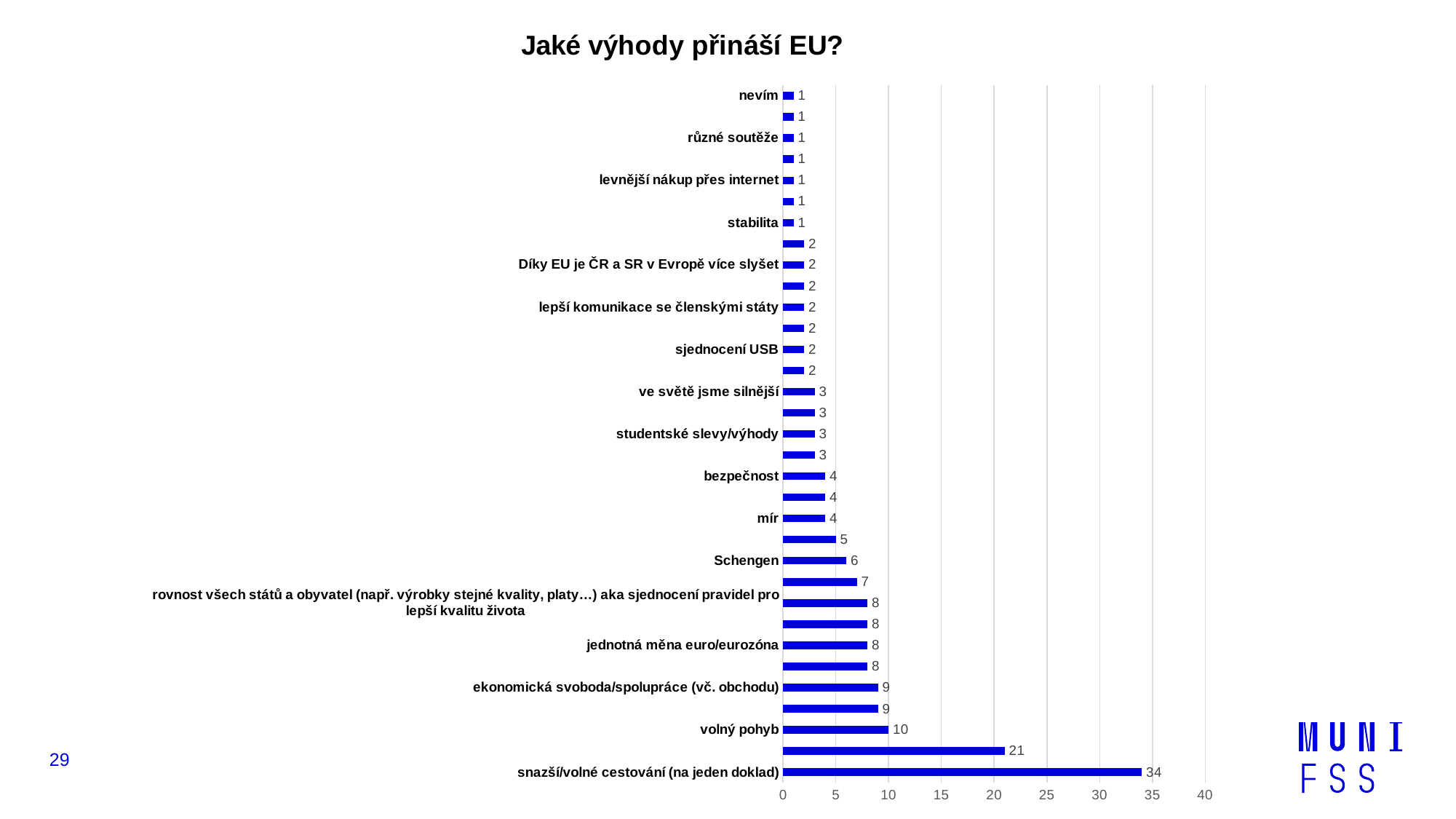
What is the title of the chart? Jaké výhody přináší EU? What is the value for "snazší/volné cestování (na jeden doklad)"? 34 Which category has the highest value? snazší/volné cestování (na jeden doklad) What kind of chart is shown on the slide? bar chart What is the value for "jednotná měna euro/eurozóna"? 8 Which has a larger value, "Schengen" or "mír"? Schengen Is the value for "snazší/volné cestování (na jeden doklad)" greater or less than 30? greater What is the difference between the values for "snazší/volné cestování (na jeden doklad)" and "volný pohyb"? 24 What is the value for "volný pohyb"? 10 How many bars are plotted in the chart? 33 What is the value for "Schengen"? 6 What is the value for "mír"? 4